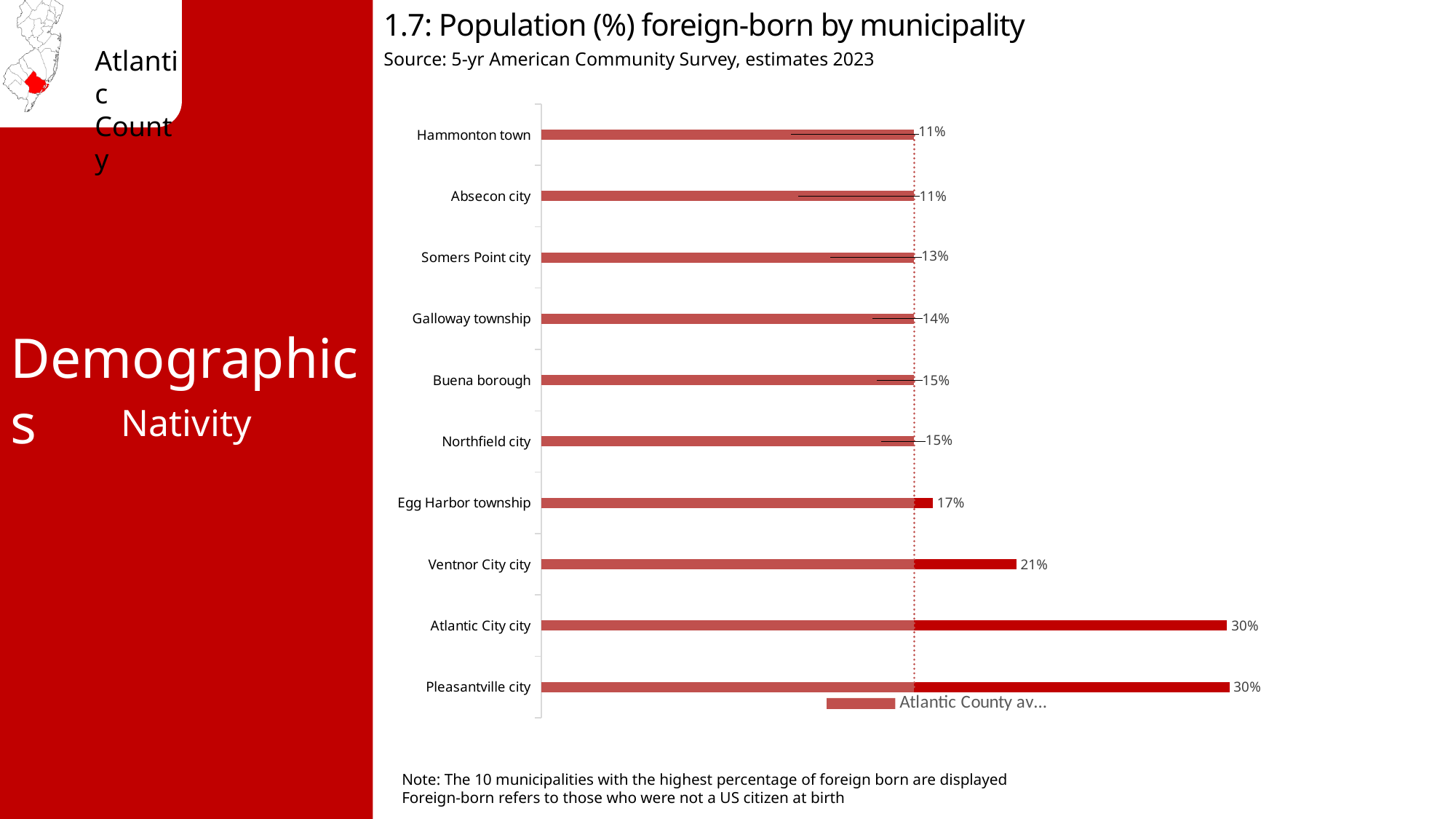
Which has a higher foreign-born percentage, Ventnor City city or Buena borough? Ventnor City city How many municipalities are shown in the chart? 10 What is the percentage of foreign-born population for Pleasantville city? 30% What is the percentage of foreign-born population for Egg Harbor township? 17% What kind of chart is used to show the foreign-born population by municipality? Bar chart What is the difference in percentage points between Atlantic City city and Ventnor City city? 9 What is the percentage of foreign-born population for Galloway township? 14% What is the percentage of foreign-born population for Ventnor City city? 21% What is the difference in percentage points between Egg Harbor township and Hammonton town? 6 What is the title of the chart? 1.7: Population (%) foreign-born by municipality Which has a higher foreign-born percentage, Galloway township or Absecon city? Galloway township What is the percentage of foreign-born population for Somers Point city? 13%